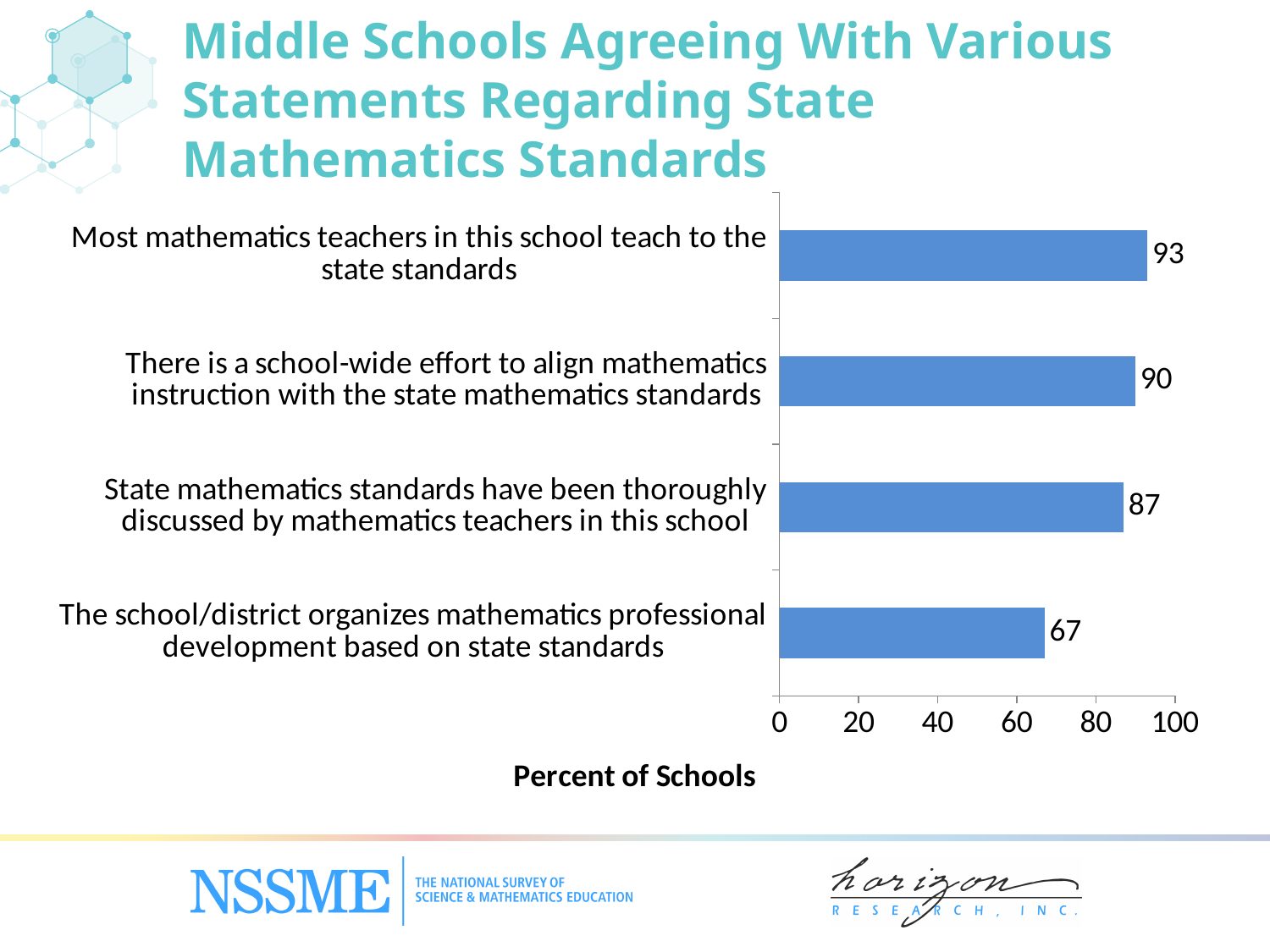
Which statement has the lowest percent of schools agreeing? The school/district organizes mathematics professional development based on state standards What is the difference between the values for the school-wide effort statement and the thoroughly discussed statement? 3 What percent of schools agree that state mathematics standards have been thoroughly discussed by mathematics teachers in this school? 87 What is the label of the horizontal axis? Percent of Schools What is the difference between the value for 'Most mathematics teachers in this school teach to the state standards' and the value for 'The school/district organizes mathematics professional development based on state standards'? 26 What percent of middle schools agree that most mathematics teachers in this school teach to the state standards? 93 Which is larger: the value for 'There is a school-wide effort to align mathematics instruction with the state mathematics standards' or the value for 'State mathematics standards have been thoroughly discussed by mathematics teachers in this school'? There is a school-wide effort to align mathematics instruction with the state mathematics standards Is the value for 'The school/district organizes mathematics professional development based on state standards' greater or less than 80? less What is the value for 'The school/district organizes mathematics professional development based on state standards'? 67 How many statements are shown in the chart? 4 What kind of chart is shown on the slide? bar chart Which statement has the highest percent of schools agreeing? Most mathematics teachers in this school teach to the state standards